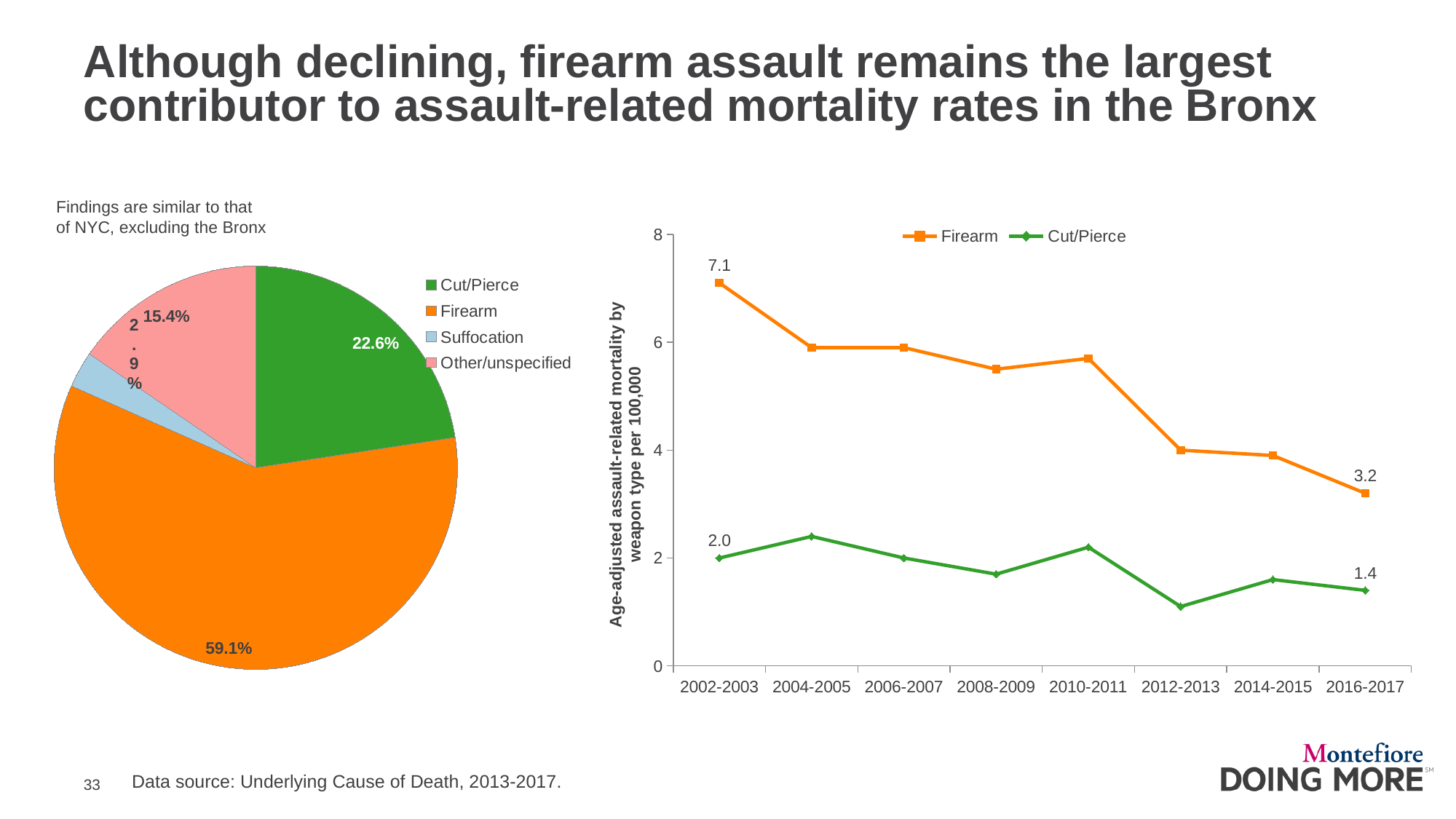
In the pie chart on the left, which category has the smallest slice? Suffocation In the pie chart on the left, what share does Firearm account for? 59.1% In the pie chart on the left, what share does Other/unspecified account for? 15.4% In the line chart on the right, what is the Firearm value for 2002-2003? 7.1 In the pie chart on the left, what share does Cut/Pierce account for? 22.6% In the line chart on the right, is the Firearm value for 2008-2009 greater or less than 6? less In the line chart on the right, how many series does the legend list? 2 In the pie chart on the left, which category has the largest slice? Firearm In the pie chart on the left, how many categories are shown? 4 In the line chart on the right, does the Firearm series generally rise or fall across the periods? fall In the line chart on the right, what is the Cut/Pierce value for 2016-2017? 1.4 In the line chart on the right, by how much did the Firearm value fall from 2002-2003 to 2016-2017? 3.9